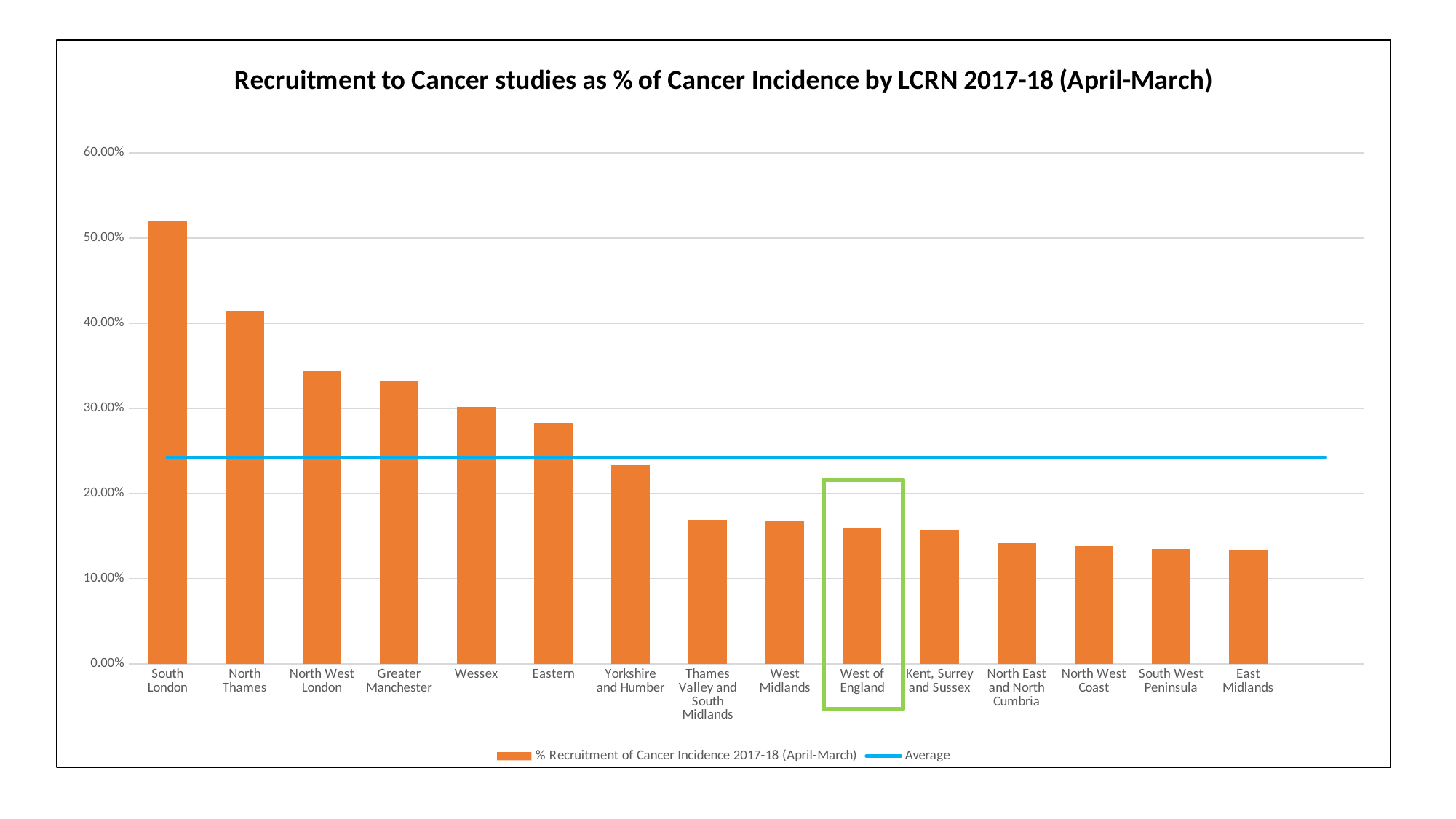
Which is larger, the value for Greater Manchester or the value for Wessex? Greater Manchester How many LCRN categories are shown on the x axis? 15 Which LCRN is highlighted with a green box on the chart? West of England Is the value for West of England greater or less than 20.00%? less Is the value for North Thames greater or less than 40.00%? greater Is the value for South London greater or less than 50.00%? greater How many series does the legend list? 2 Do the bar values rise or fall moving from left to right along the x axis? Fall What kind of chart is shown on the slide? Bar chart Which LCRN has the highest recruitment as % of cancer incidence? South London